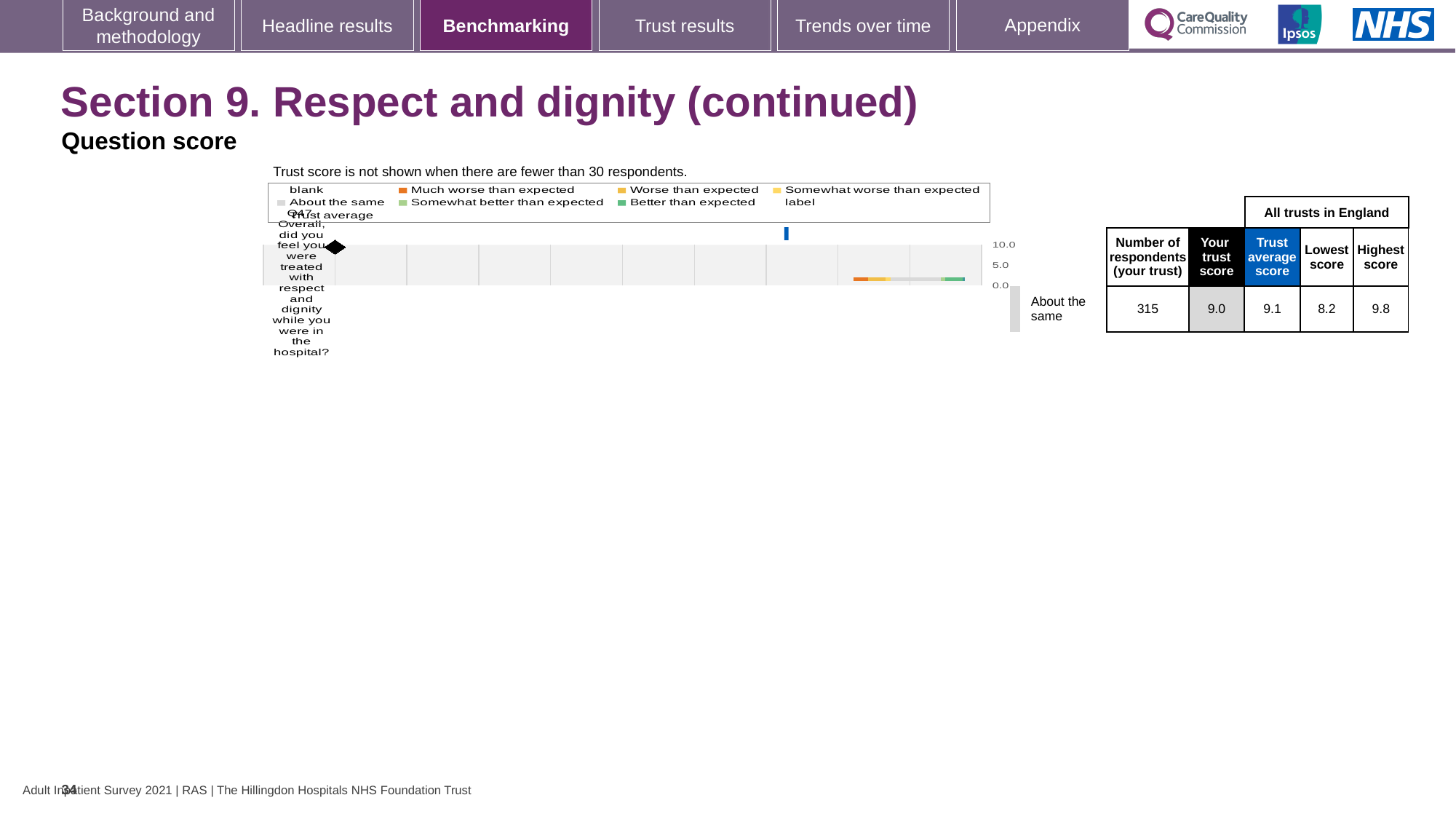
What benchmarking category is the trust's Q47 result placed in? About the same What is the highest value shown on the chart's score axis? 10.0 What is the trust average score for Q47 across all trusts in England? 9.1 What is your trust score for Q47? 9.0 What is the lowest score among all trusts in England for Q47? 8.2 What is the highest score among all trusts in England for Q47? 9.8 What kind of chart is used to show the Q47 benchmarking result? bar chart Which is larger for Q47: your trust score or the trust average score? Trust average score How many questions are plotted on the benchmarking chart? 1 What is the difference between the highest score and the lowest score for Q47? 1.6 What is the number of respondents for your trust shown for Q47? 315 Which colour in the legend represents 'Much worse than expected'? orange